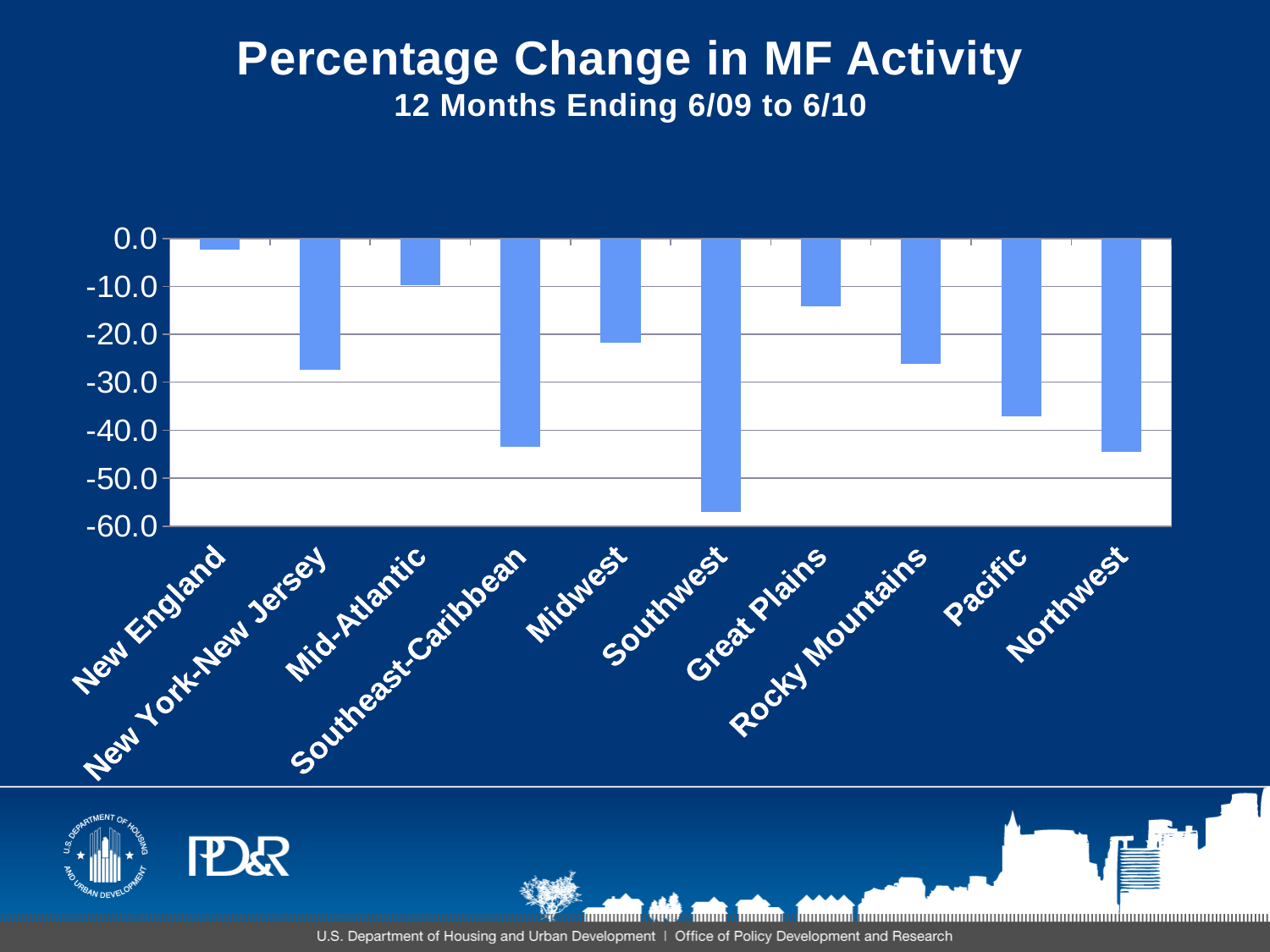
Which region has the lowest (most negative) percentage change in MF activity? Southwest Is the value for Pacific greater or less than -30.0? less Is the value for Southwest greater or less than -50.0? less How many regions are plotted on the chart? 10 What kind of chart is shown on the slide? bar chart Is the value for Great Plains greater or less than -20.0? greater Which region has the highest (least negative) percentage change in MF activity? New England What period does the chart's subtitle say the data covers? 12 Months Ending 6/09 to 6/10